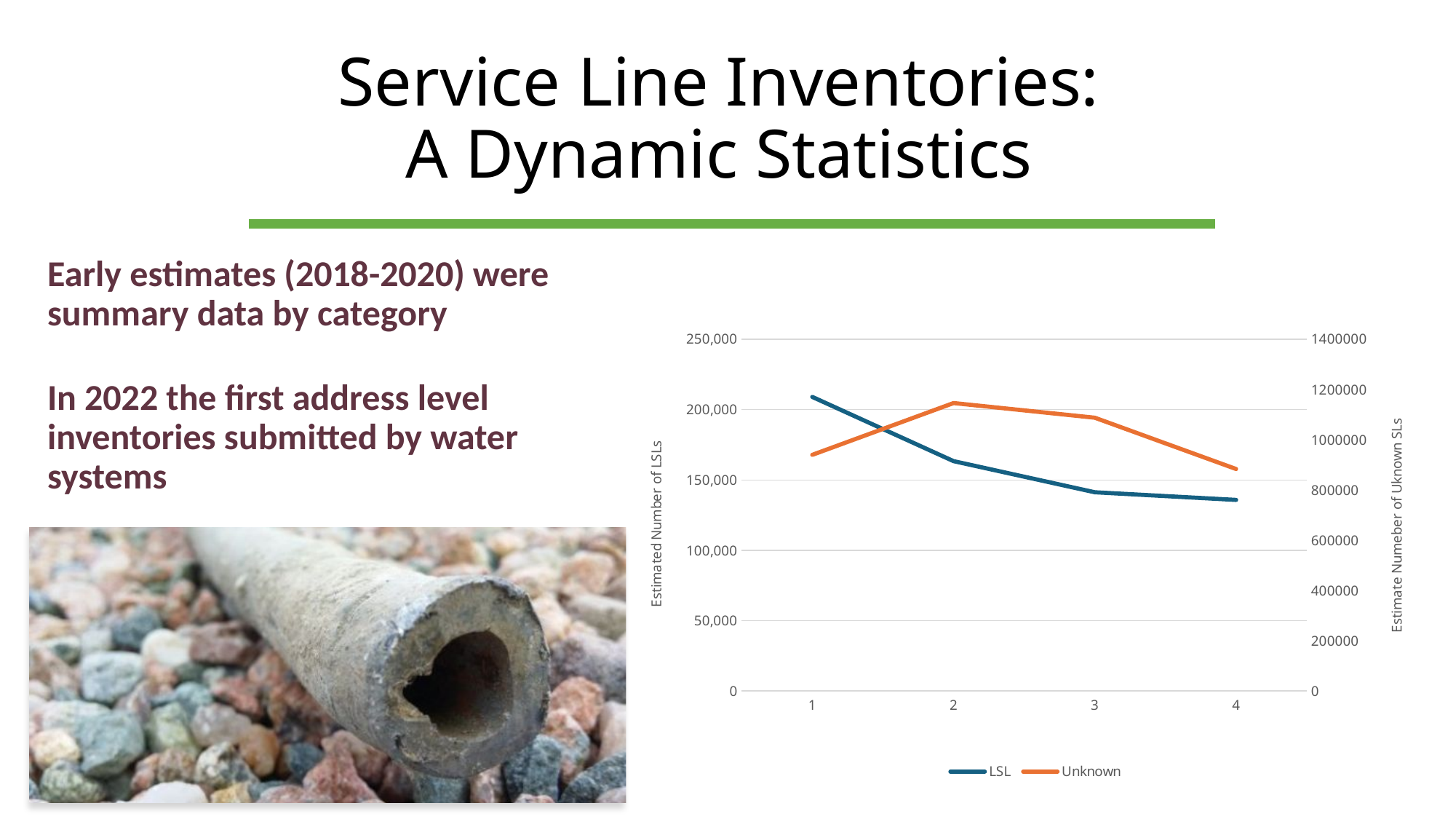
At which x-axis point is the LSL series highest? 1 At which x-axis point is the Unknown series highest? 2 Does the LSL series rise or fall from point 1 to point 4? fall What kind of chart is shown on the slide? line chart How many series does the chart legend list? 2 Which series is drawn in orange? Unknown How many points are plotted along the x axis for each series? 4 What is the title of the left vertical axis? Estimated Number of LSLs Is the Unknown value at point 2 greater or less than 1000000? greater Is the LSL value at point 1 greater or less than 200,000? greater At which x-axis point is the Unknown series lowest? 4 Is the LSL value at point 4 greater or less than 150,000? less